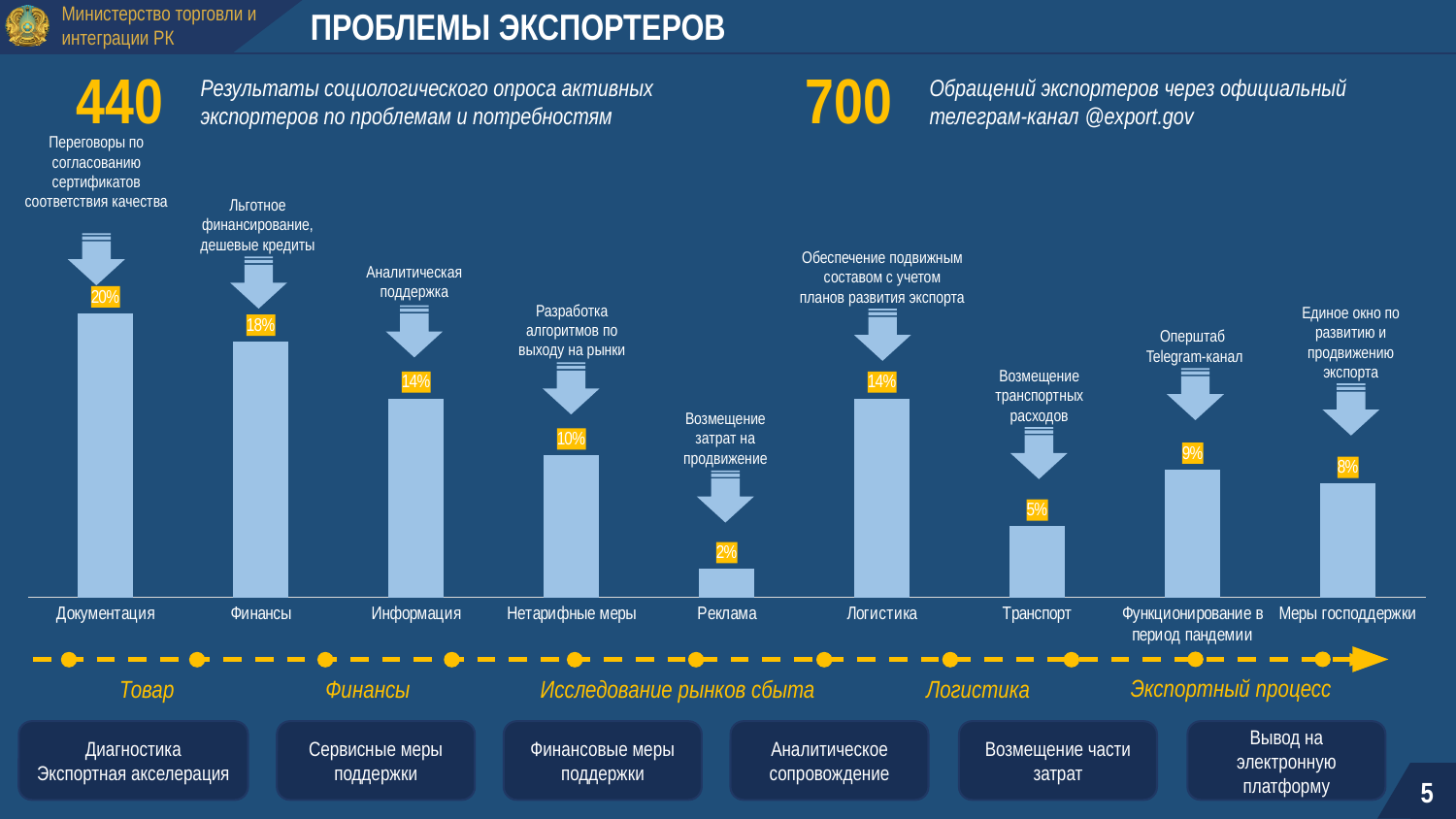
Which category has the highest value? Документация What is the value for Транспорт? 5% What is the value for Реклама? 2% Which category has the lowest value? Реклама Which is larger, the value for Нетарифные меры or the value for Транспорт? Нетарифные меры What is the value for Документация? 20% What is the value for Финансы? 18% What kind of chart is shown on the slide? Bar chart What is the value for Функционирование в период пандемии? 9% What is the value for Меры господдержки? 8% How many categories are shown in the bar chart? 9 What is the difference between the values for Документация and Финансы? 2%